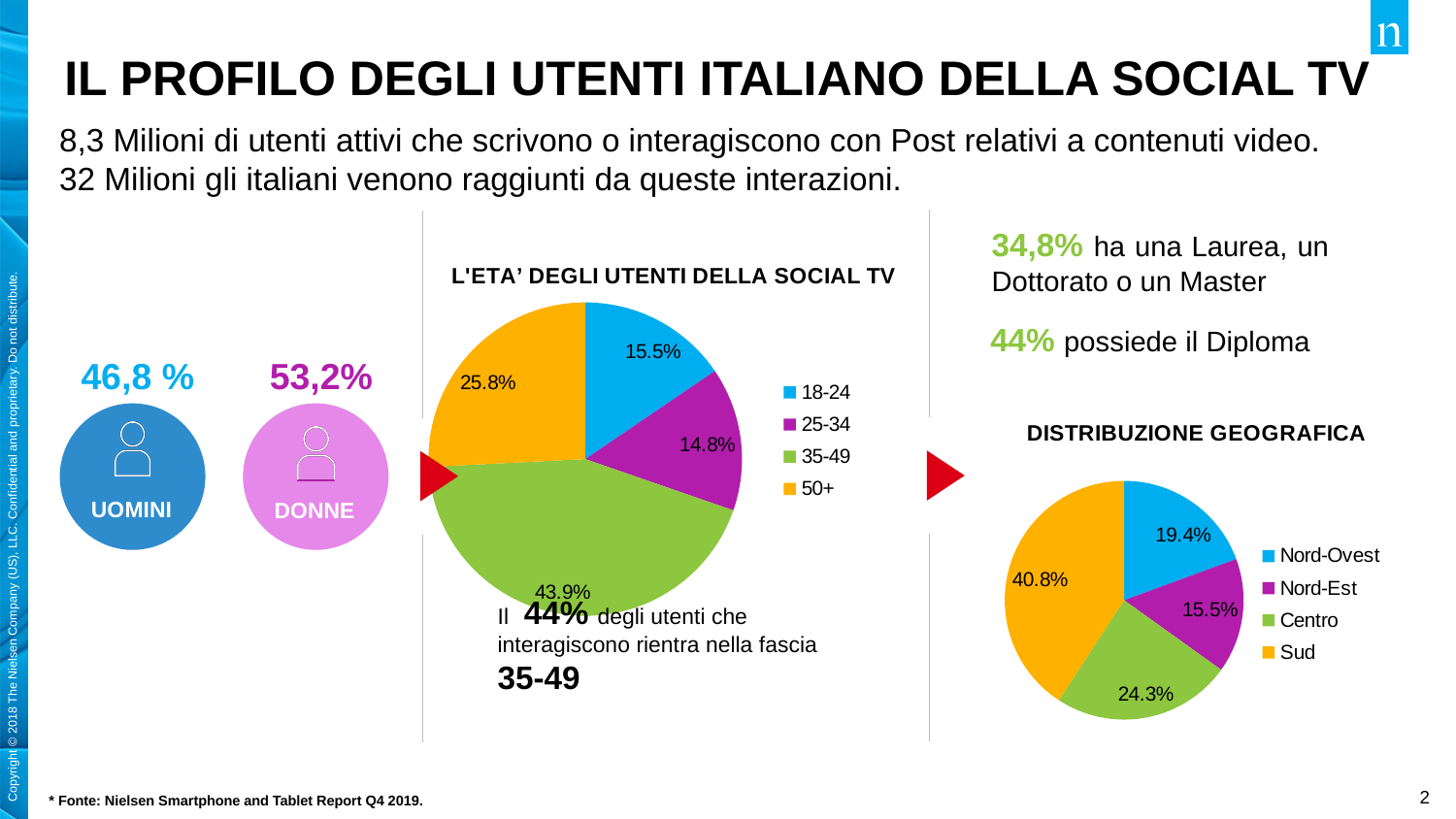
In the chart titled "L'ETA' DEGLI UTENTI DELLA SOCIAL TV", which age group has the smallest share? 25-34 What kind of chart is "DISTRIBUZIONE GEOGRAFICA"? Pie chart In the chart titled "L'ETA' DEGLI UTENTI DELLA SOCIAL TV", how many age groups are shown? 4 In the chart titled "DISTRIBUZIONE GEOGRAFICA", what is the value for Centro? 24.3% In the chart titled "L'ETA' DEGLI UTENTI DELLA SOCIAL TV", what is the value for the 35-49 slice? 43.9% In the chart titled "L'ETA' DEGLI UTENTI DELLA SOCIAL TV", what is the value for the 50+ slice? 25.8% In the chart titled "DISTRIBUZIONE GEOGRAFICA", which is larger, Nord-Ovest or Centro? Centro In the chart titled "DISTRIBUZIONE GEOGRAFICA", what is the difference between Sud and Nord-Ovest? 21.4% In the chart titled "DISTRIBUZIONE GEOGRAFICA", which region has the smallest share? Nord-Est In the chart titled "L'ETA' DEGLI UTENTI DELLA SOCIAL TV", which age group has the largest share? 35-49 In the chart titled "L'ETA' DEGLI UTENTI DELLA SOCIAL TV", what is the difference between the 35-49 and 50+ slices? 18.1% In the chart titled "DISTRIBUZIONE GEOGRAFICA", what is the value for Sud? 40.8%